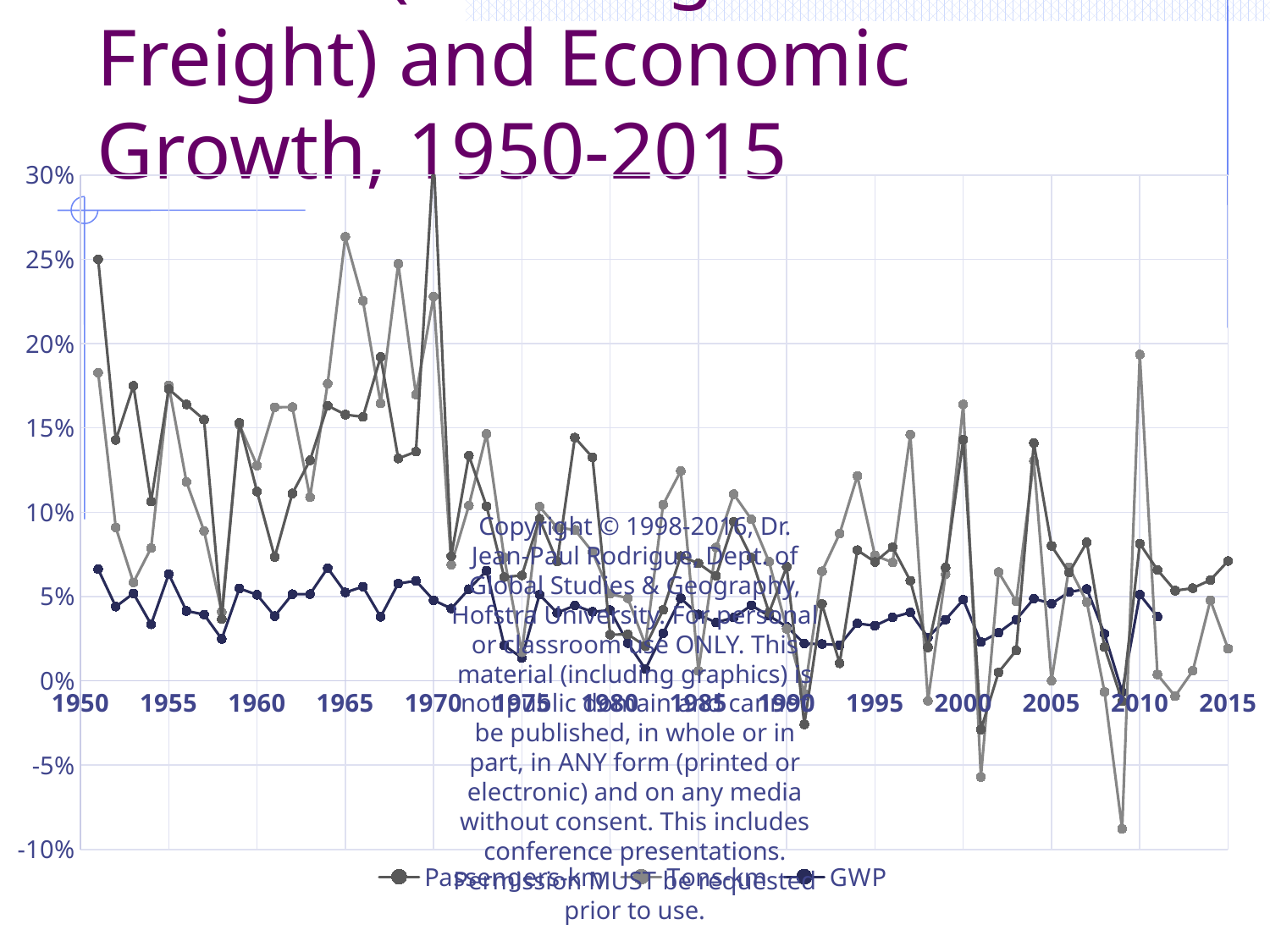
Is the value for GWP in 2009 greater or less than 0%? less How many series does the legend list? 3 What are the three series named in the legend? Passengers-km, Tons-km, GWP What kind of chart is shown on the slide? Line chart What is the lowest value shown on the vertical axis? -10% Is the value for Passengers-km in 1951 greater or less than 20%? greater Is the value for Passengers-km in 1970 greater or less than 25%? greater Which series has the highest value in 2010? Tons-km Which series reaches the highest value anywhere on the chart? Passengers-km In 2009, which is larger: the value for Tons-km or the value for GWP? GWP